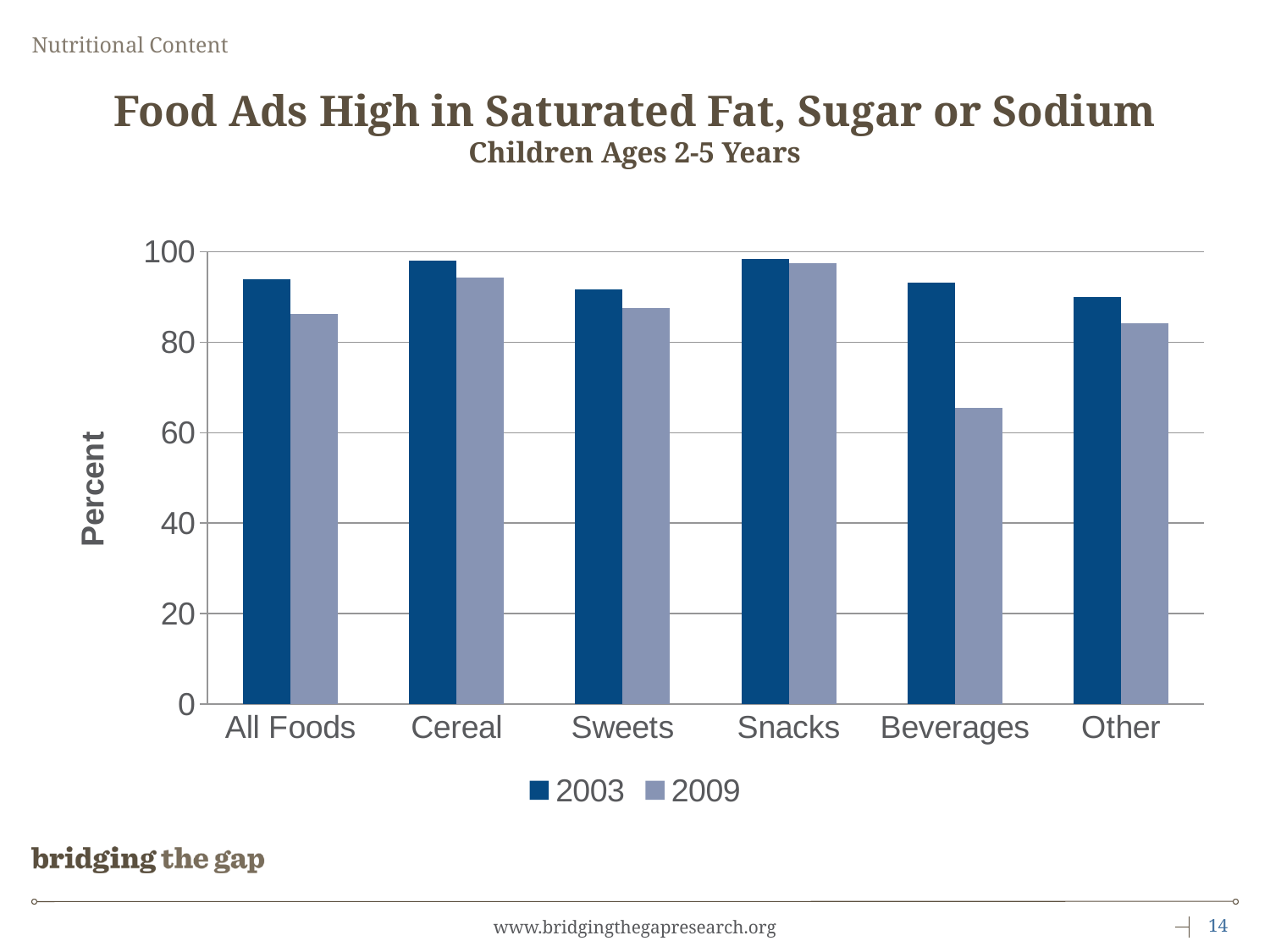
Is the 2009 value for All Foods greater or less than 80? greater Is the 2009 value for Beverages greater or less than 60? greater Which category has the lowest value for 2009? Beverages What kind of chart is shown on the slide? bar chart For All Foods, which year has the larger value, 2003 or 2009? 2003 Is the 2003 value for Other greater or less than 80? greater How many series does the legend list? 2 What age group does the chart subtitle refer to? Children Ages 2-5 Years For Beverages, which year has the larger value, 2003 or 2009? 2003 What is the label on the y axis? Percent How many food categories are shown on the x axis? 6